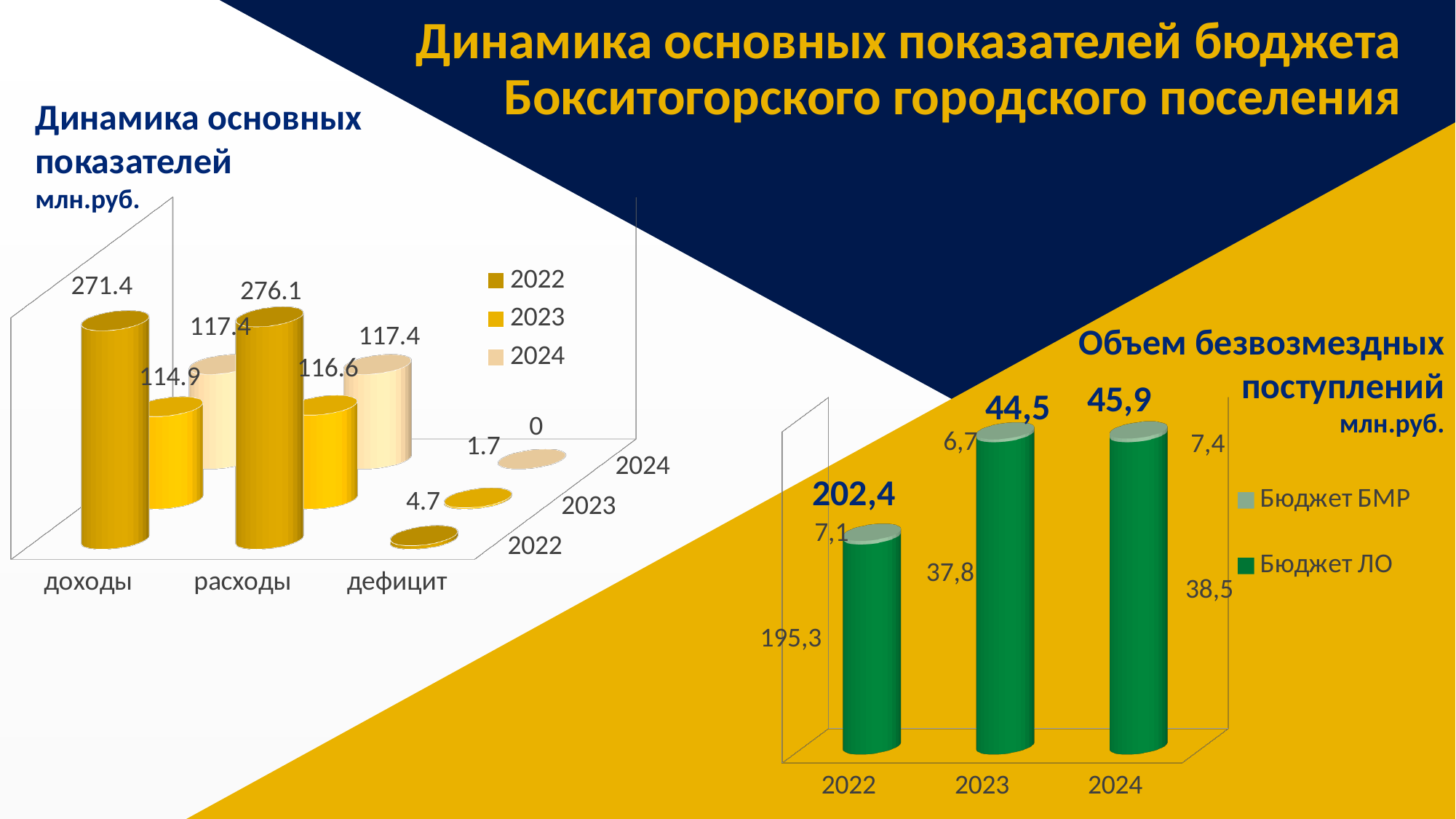
On the chart 'Объем безвозмездных поступлений', which year has the highest total? 2022 On the chart 'Динамика основных показателей', what is the difference between расходы and доходы in 2022? 4.7 What kind of chart is 'Объем безвозмездных поступлений'? Stacked bar chart On the chart 'Объем безвозмездных поступлений', what is the total of the stacked bar for 2024? 45,9 On the chart 'Динамика основных показателей', which year has the highest value for расходы? 2022 On the chart 'Динамика основных показателей', how many series does the legend list? 3 On the chart 'Объем безвозмездных поступлений', what is the value for Бюджет ЛО in 2023? 37,8 On the chart 'Динамика основных показателей', what is the value for дефицит in 2024? 0 On the chart 'Динамика основных показателей', what is the value for расходы in 2023? 116.6 On the chart 'Объем безвозмездных поступлений', which is larger: Бюджет БМР in 2022 or Бюджет БМР in 2023? 2022 On the chart 'Динамика основных показателей', how does the value for дефицит change from 2022 to 2024? It falls On the chart 'Динамика основных показателей', what is the value for доходы in 2022? 271.4